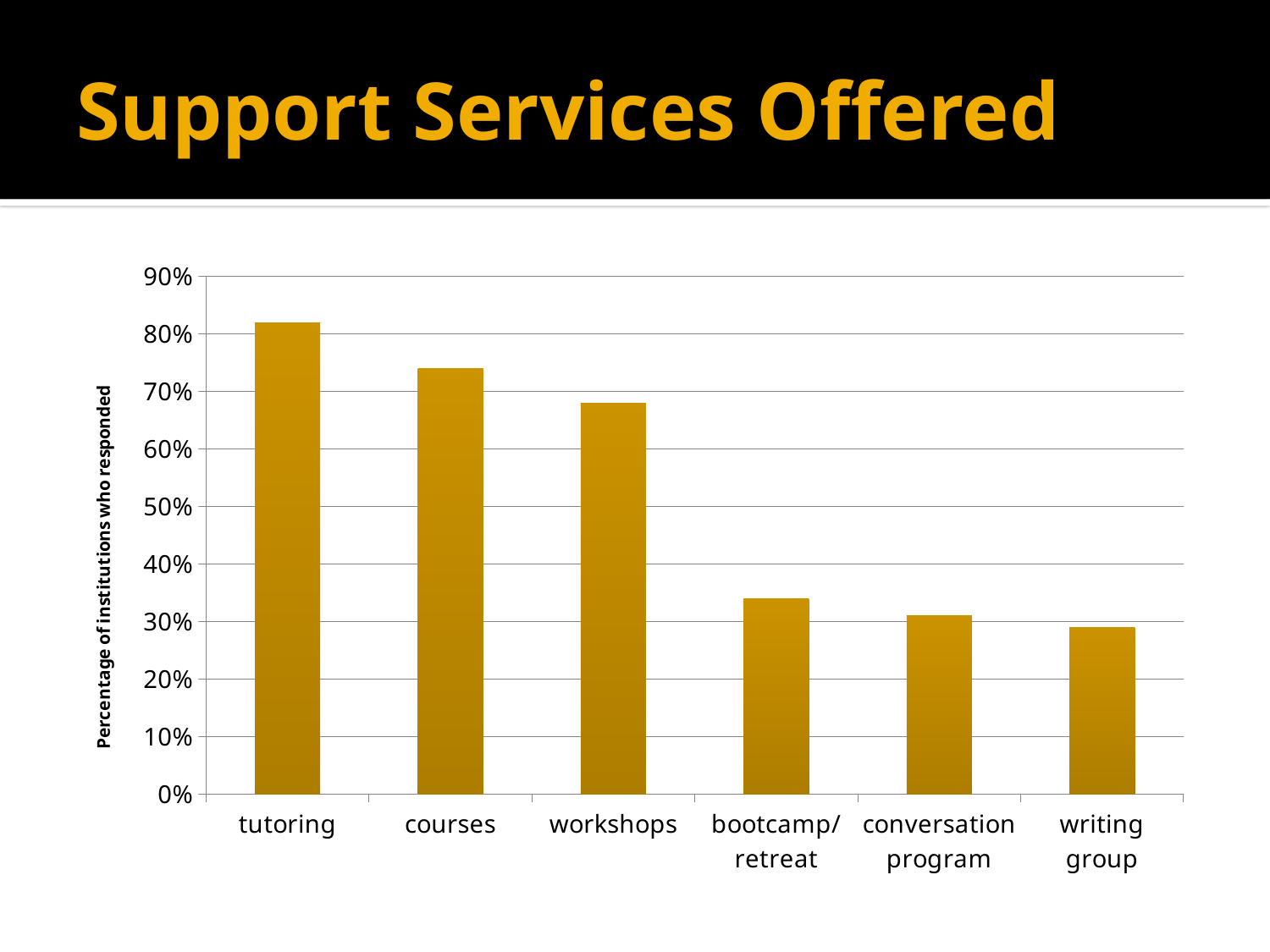
Is the value for workshops greater or less than 70%? less Which support service has the highest percentage of institutions? tutoring Is the value for courses greater or less than 70%? greater Do the values rise or fall moving from left to right along the x axis? fall What is the label on the vertical axis? Percentage of institutions who responded Which is larger, the value for courses or the value for workshops? courses Is the value for bootcamp/retreat greater or less than 40%? less How many support service categories are shown on the x axis? 6 What kind of chart is shown on the slide? bar chart Which is larger, the value for bootcamp/retreat or the value for writing group? bootcamp/retreat